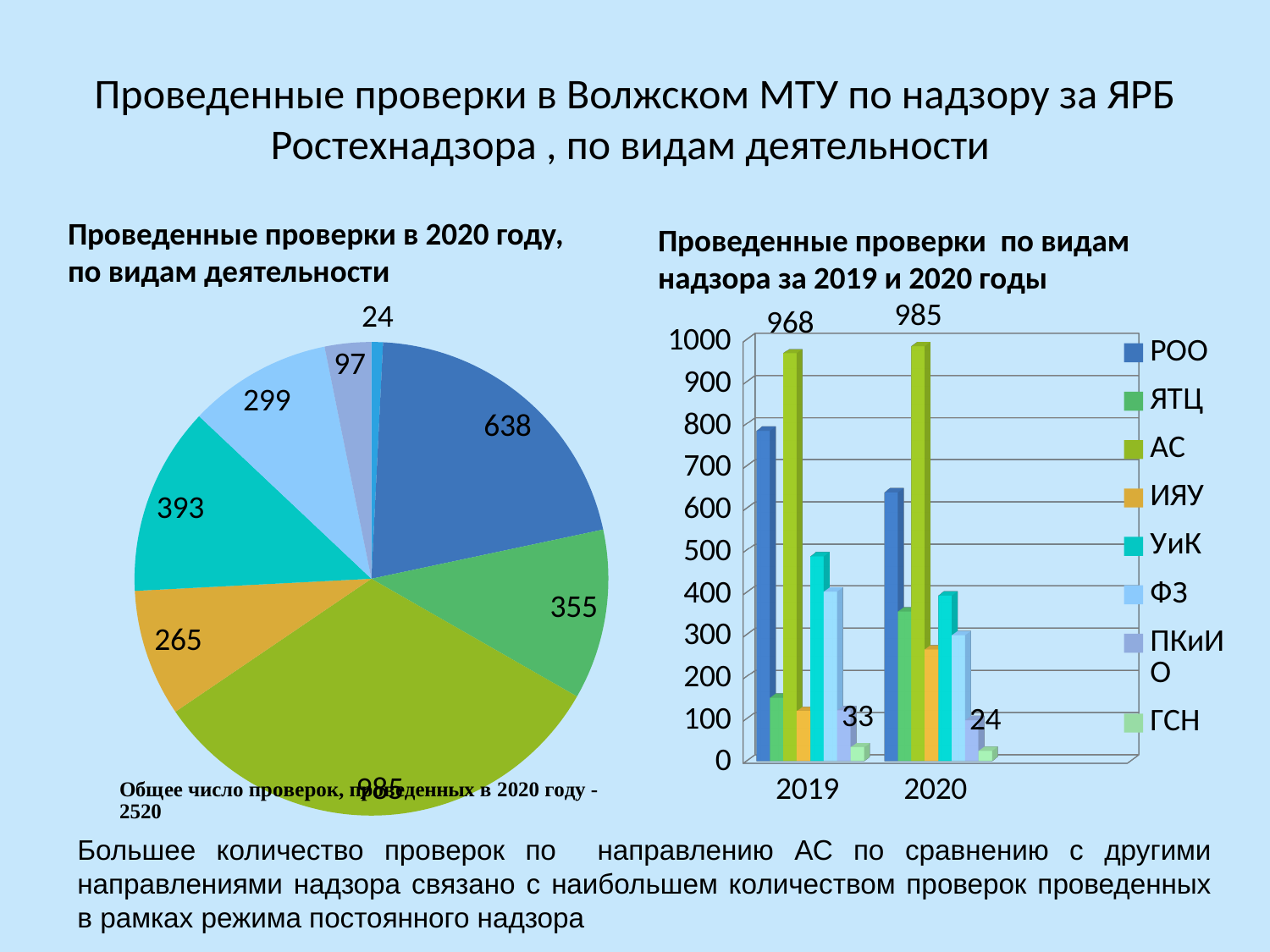
In the right chart, which series has the highest value in 2020? АС In the right chart, is the value for РОО larger in 2019 or in 2020? 2019 In the right chart, what is the value for АС in 2020? 985 In the right chart, by how much did the value for АС increase from 2019 to 2020? 17 In the right chart, how many series does the legend list? 8 What kind of chart is the right chart, 'Проведенные проверки по видам надзора за 2019 и 2020 годы'? bar chart In the left pie chart, what is the value of the largest slice? 985 In the left pie chart, how many slices are there? 8 In the right chart, is the value for РОО in 2019 greater or less than 700? greater In the right chart, what is the value for АС in 2019? 968 In the right chart, how many categories are shown on the x axis? 2 What kind of chart is the left chart, 'Проведенные проверки в 2020 году, по видам деятельности'? pie chart